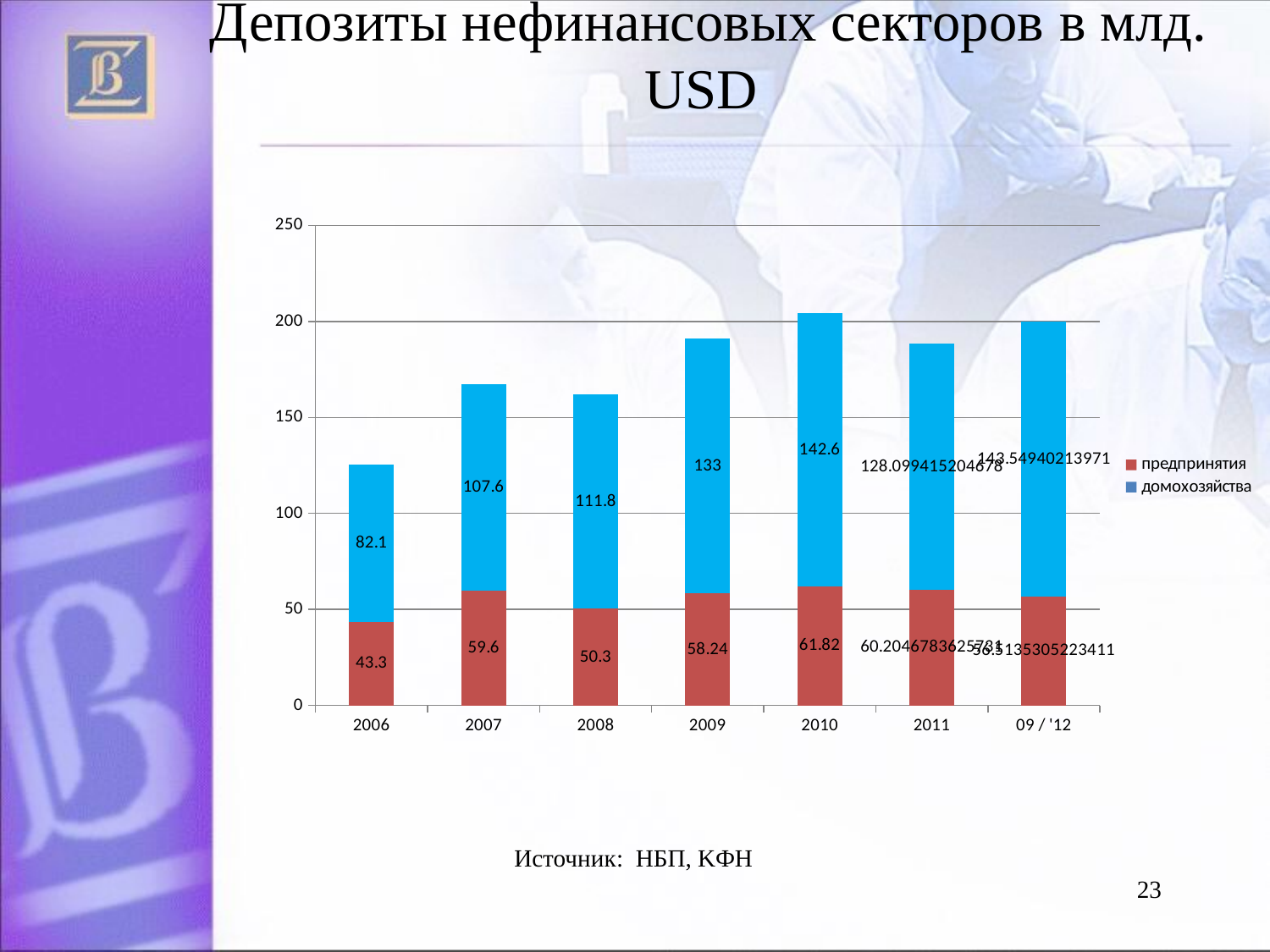
What is the value for предпринятия in 2006? 43.3 Is the total of the stacked bar for 2011 greater or less than 150? greater How many categories are shown on the x axis? 7 What is the value for домохозяйства in 2010? 142.6 In which year is the value for предпринятия the lowest? 2006 What is the value for предпринятия in 2008? 50.3 In which year is the value for домохозяйства the lowest? 2006 What type of chart is shown on the slide? stacked bar chart How many series does the legend list? 2 What is the total of the stacked bar for 2007? 167.2 What is the difference between the домохозяйства values for 2010 and 2009? 9.6 What is the value for домохозяйства in 2009? 133